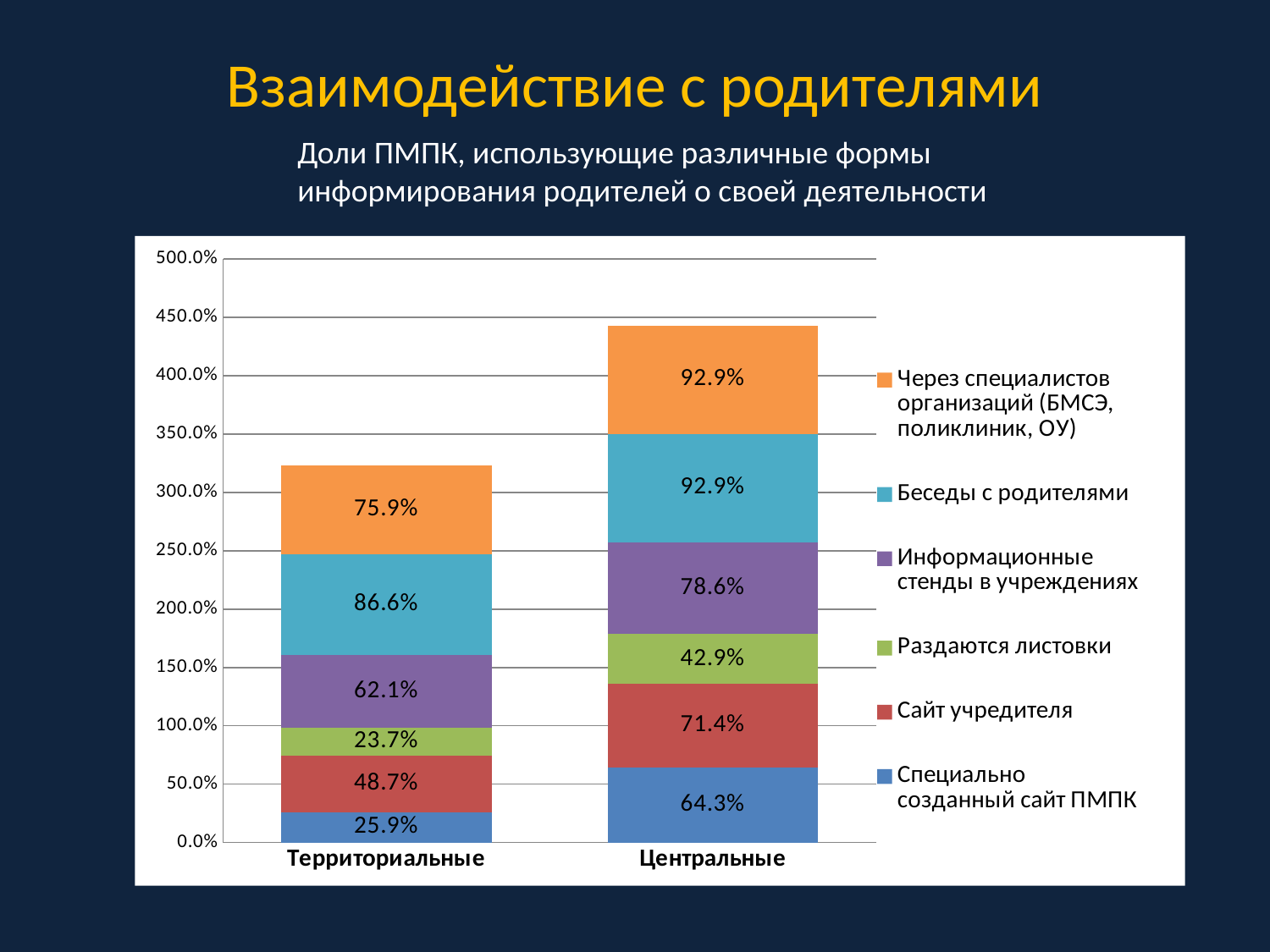
How many series does the legend list? 6 What kind of chart is shown on the slide? Stacked bar chart Is the total height of the "Центральные" stacked bar greater or less than 400.0%? greater How many categories are shown on the x axis? 2 What is the total of the "Территориальные" stacked bar? 322.9% Which category has the larger value for "Информационные стенды в учреждениях"? Центральные Which series has the lowest value in the "Территориальные" bar? Раздаются листовки What is the difference between the "Сайт учредителя" values for "Центральные" and "Территориальные"? 22.7% What is the value for "Специально созданный сайт ПМПК" in the "Центральные" bar? 64.3% What is the value for "Раздаются листовки" in the "Территориальные" bar? 23.7% What is the value for "Беседы с родителями" in the "Территориальные" bar? 86.6% Which series has the lowest value in the "Центральные" bar? Раздаются листовки